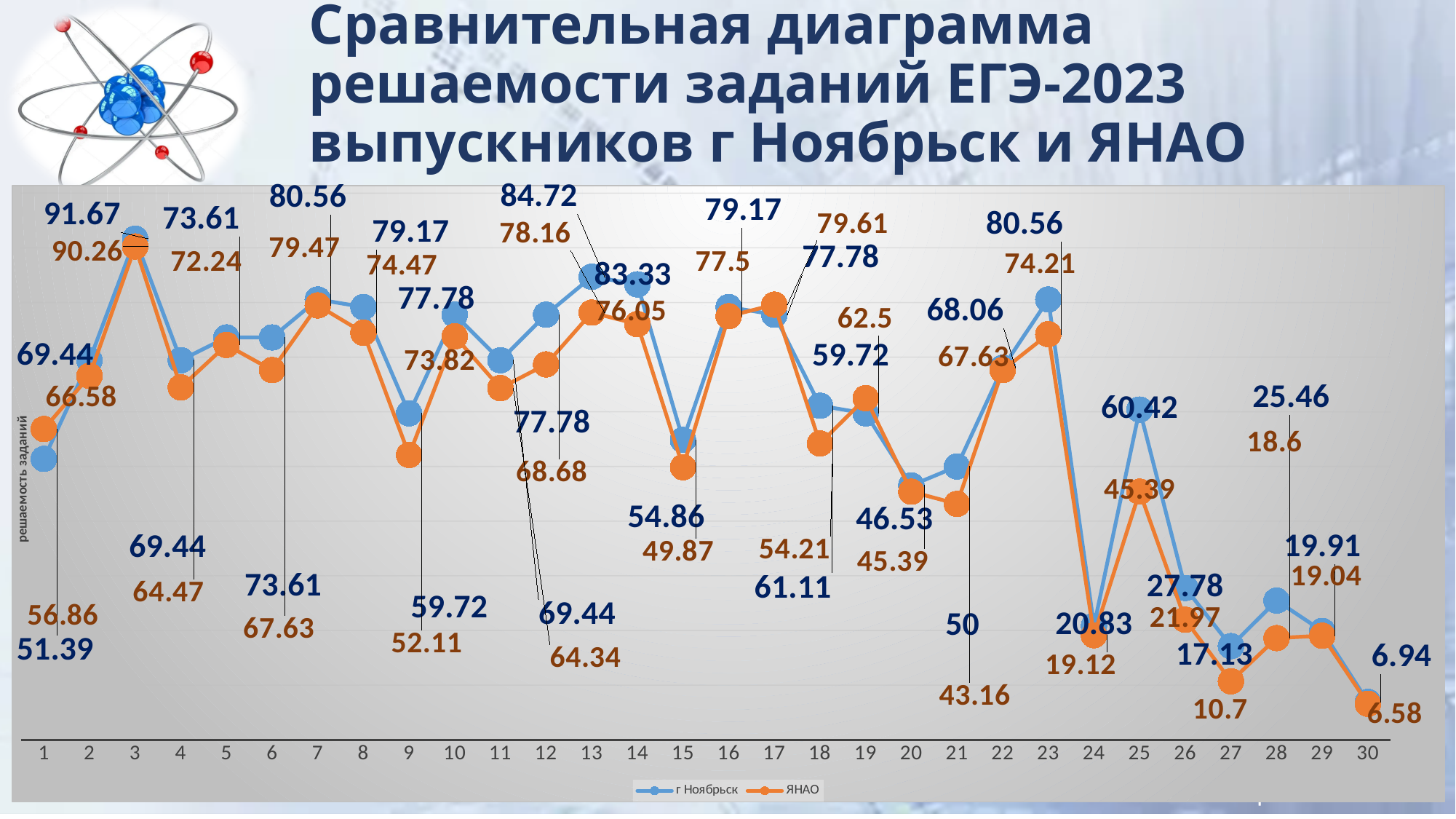
What is the value for ЯНАО at task 3? 90.26 What is the value for г Ноябрьск at task 30? 6.94 What kind of chart is shown on the slide? line chart At which task does г Ноябрьск reach its highest value? 3 What is the value for г Ноябрьск at task 3? 91.67 What is the value for ЯНАО at task 27? 10.7 How many series does the legend list? 2 How many task numbers are shown along the x axis? 30 What is the difference between г Ноябрьск and ЯНАО at task 25? 15.03 At which task does ЯНАО have its lowest value? 30 Which series is drawn in orange? ЯНАО At task 25, which series has the larger value, г Ноябрьск or ЯНАО? г Ноябрьск